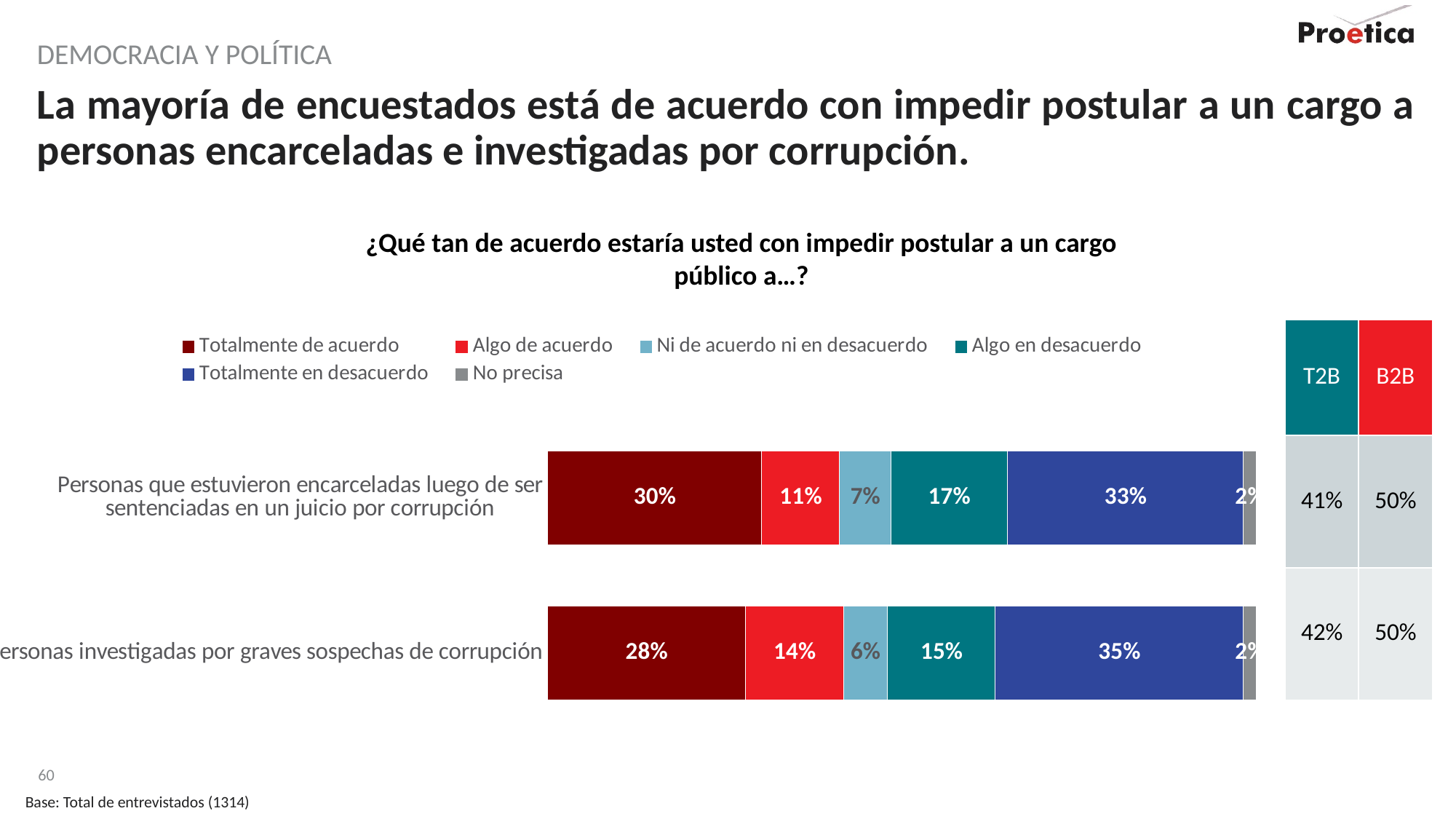
How many categories (bars) are plotted in the chart? 2 What is the 'Totalmente en desacuerdo' value for 'Personas investigadas por graves sospechas de corrupción'? 35% What is the 'Ni de acuerdo ni en desacuerdo' value for 'Personas que estuvieron encarceladas luego de ser sentenciadas en un juicio por corrupción'? 7% What is the T2B value shown for 'Personas investigadas por graves sospechas de corrupción'? 42% Which series has the highest value for 'Personas investigadas por graves sospechas de corrupción'? Totalmente en desacuerdo Which category has the larger 'Totalmente de acuerdo' value? Personas que estuvieron encarceladas luego de ser sentenciadas en un juicio por corrupción What kind of chart is shown on the slide? Stacked bar chart What is the difference between the 'Algo en desacuerdo' values for the two categories? 2% What is the 'Totalmente de acuerdo' value for 'Personas que estuvieron encarceladas luego de ser sentenciadas en un juicio por corrupción'? 30% Which series has the lowest value for 'Personas que estuvieron encarceladas luego de ser sentenciadas en un juicio por corrupción'? No precisa What is the 'Algo de acuerdo' value for 'Personas investigadas por graves sospechas de corrupción'? 14% How many series does the legend list? 6